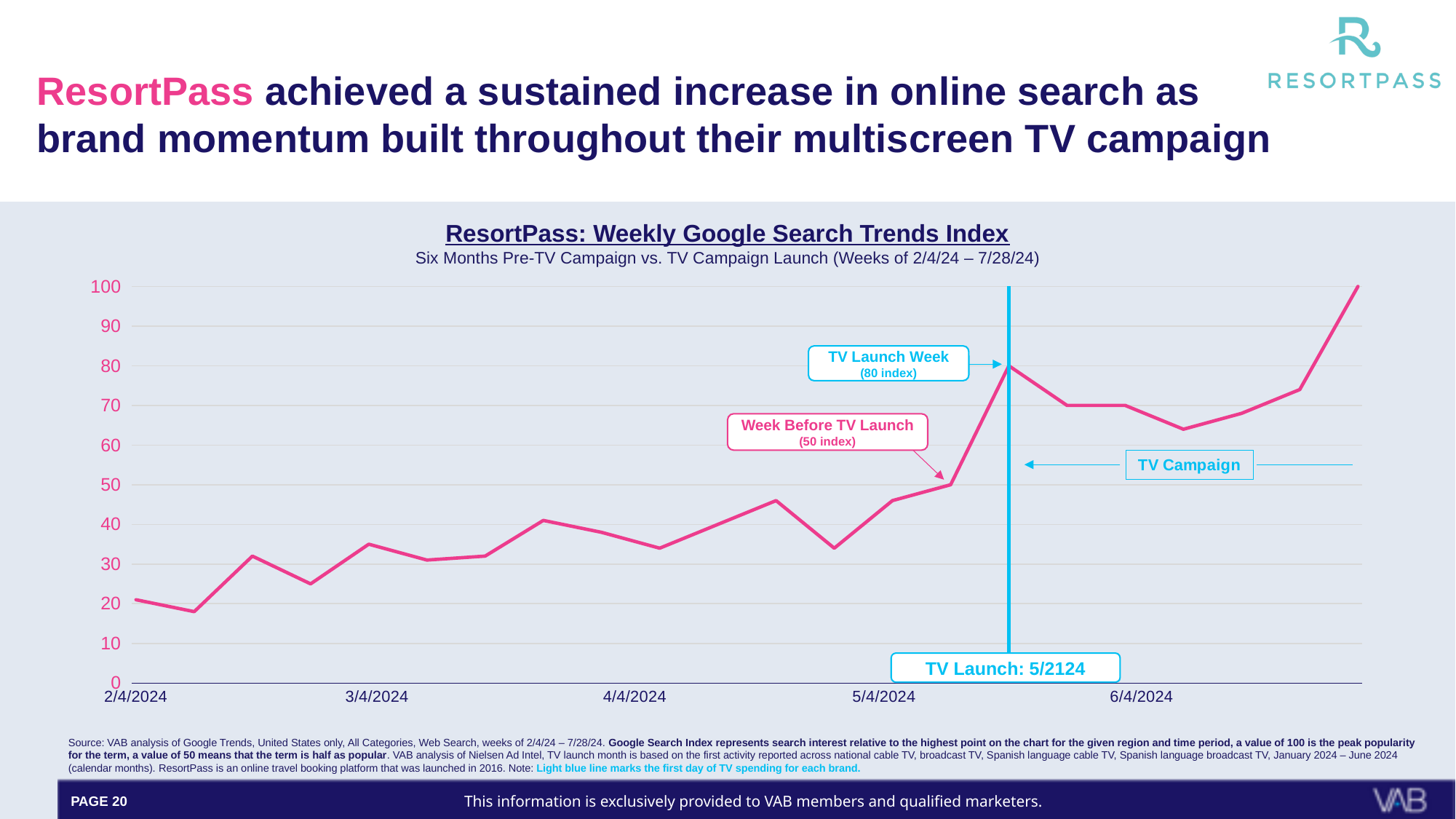
What is the search index value for the TV Launch Week? 80 Which is higher, the index for the TV Launch Week or the Week Before TV Launch? TV Launch Week By how much did the index rise from the Week Before TV Launch to the TV Launch Week? 30 What is the search index value for the Week Before TV Launch? 50 What does the vertical light blue line on the chart mark? TV Launch What is the highest index value reached on the chart? 100 How many data series are plotted on the chart? 1 Overall, does the search index rise or fall from the week of 2/4/2024 to the last week shown? rise Is the index value for the week of 2/4/2024 greater or less than 30? less Is the index value for the week of 6/4/2024 greater or less than 60? greater What kind of chart is shown on the slide? line chart